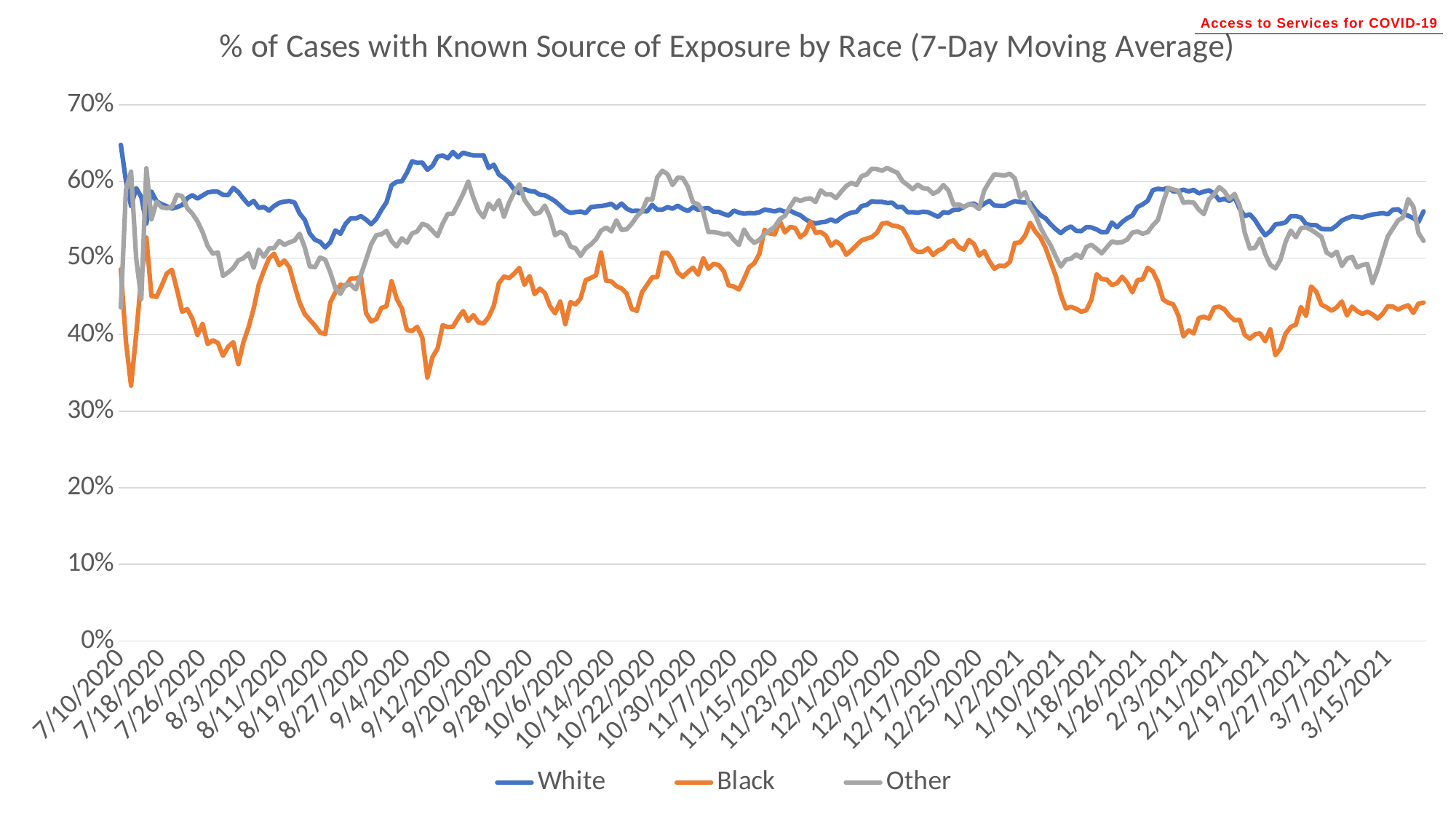
How many series does the legend list? 3 Is the value for Other around 12/9/2020 greater or less than 50%? greater Is the value for Black at 3/15/2021 greater or less than 50%? less Which series is drawn in orange? Black What is the title of the chart? % of Cases with Known Source of Exposure by Race (7-Day Moving Average) What kind of chart is shown on the slide? line chart Which series stays lowest for most of the period shown? Black Around 9/12/2020, which series has the higher value, White or Black? White Around 2/19/2021, which series has the higher value, Black or Other? Other Is the value for White around 9/20/2020 greater or less than 60%? greater